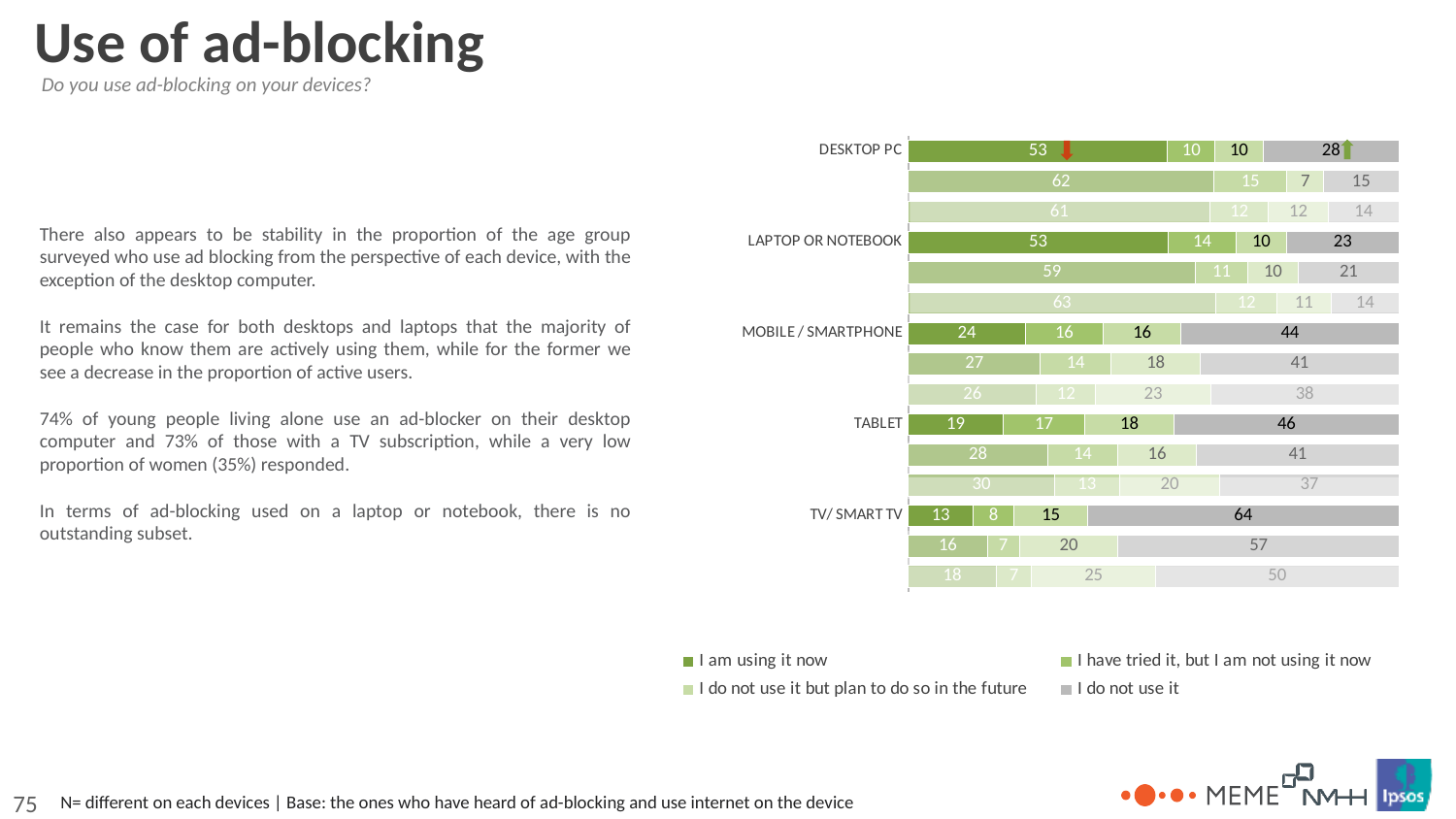
What is the difference between the 'I am using it now' values in the top bars for DESKTOP PC and MOBILE / SMARTPHONE? 29 How many device categories are labelled on the chart's axis? 5 In the top bars, is the 'I do not use it' value larger for TABLET or for LAPTOP OR NOTEBOOK? TABLET In the top bar for DESKTOP PC, what is the value for 'I am using it now'? 53 Among the top bars of each device, which device has the highest 'I do not use it' value? TV/ SMART TV How many series does the legend list? 4 What is the total of the top bar for LAPTOP OR NOTEBOOK (53, 14, 10 and 23)? 100 In the top bar for TV/ SMART TV, what is the value for 'I do not use it'? 64 In the top bar for TABLET, what is the value for 'I have tried it, but I am not using it now'? 17 What kind of chart is shown on the slide? Stacked bar chart Among the top bars of each device, which device has the lowest 'I am using it now' value? TV/ SMART TV In the top bar for MOBILE / SMARTPHONE, what is the value for 'I do not use it but plan to do so in the future'? 16